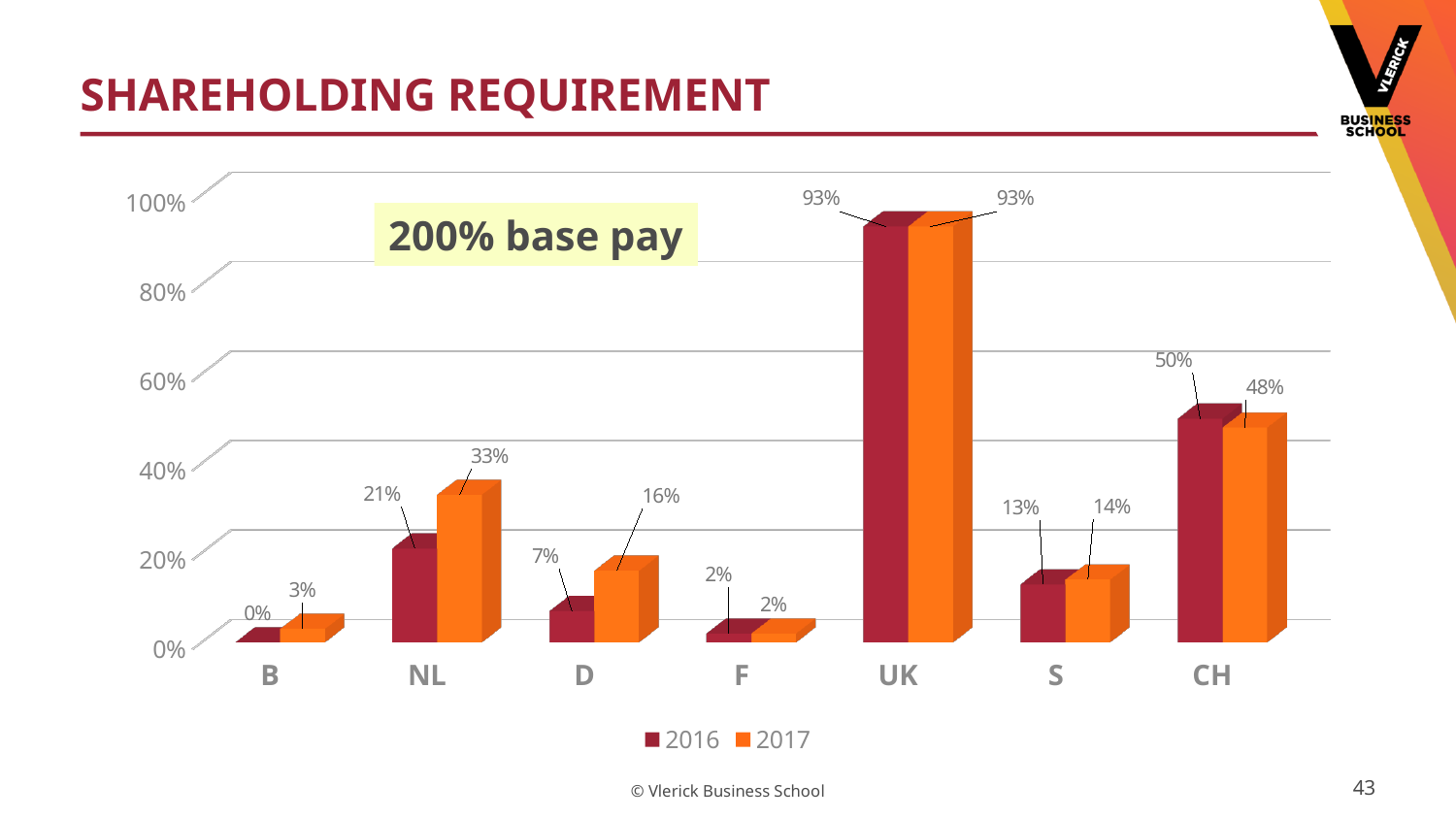
What is the difference between the 2017 and 2016 values for NL? 12% What is the title of the slide? SHAREHOLDING REQUIREMENT Which category has the highest 2017 value? UK Which category has the lowest 2016 value? B What is the 2016 value for B? 0% How many series does the legend list? 2 How many categories are shown on the x axis? 7 What is the 2017 value for NL? 33% What text is shown in the highlighted box on the chart? 200% base pay What kind of chart is shown on the slide? bar chart What is the 2016 value for CH? 50% Which is larger for CH, the 2016 value or the 2017 value? 2016